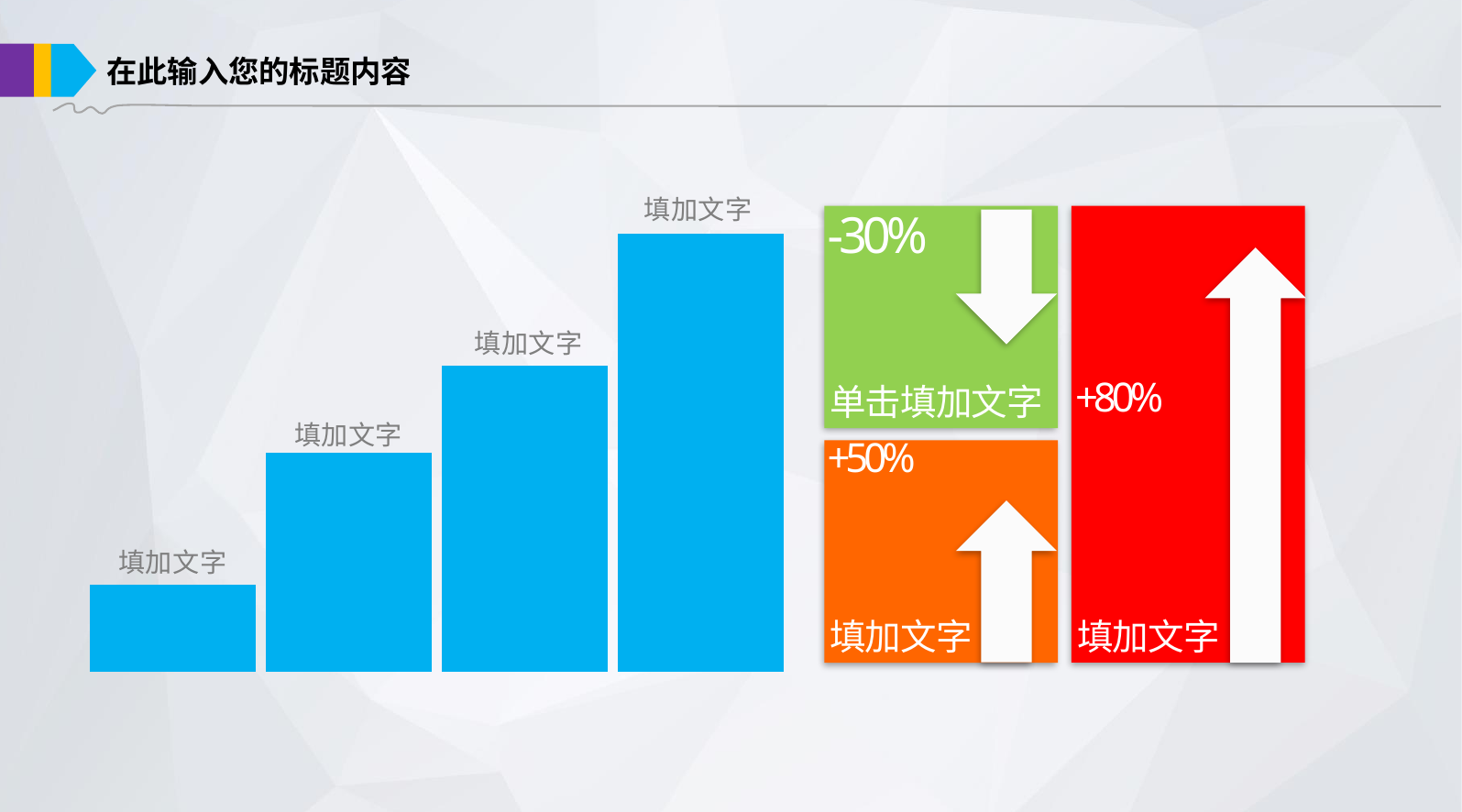
What kind of chart is shown on the left of the slide? bar chart Do the bars in the chart rise or fall from left to right? rise Is the rightmost bar taller or shorter than the leftmost bar? taller Which bar in the chart is the tallest: the leftmost, second, third, or rightmost? rightmost What label text appears above each bar in the chart? 填加文字 Which bar in the chart is the shortest: the leftmost, second, third, or rightmost? leftmost What colour are the bars in the chart? blue How many bars does the bar chart have? 4 Is the second bar from the left taller or shorter than the third bar from the left? shorter